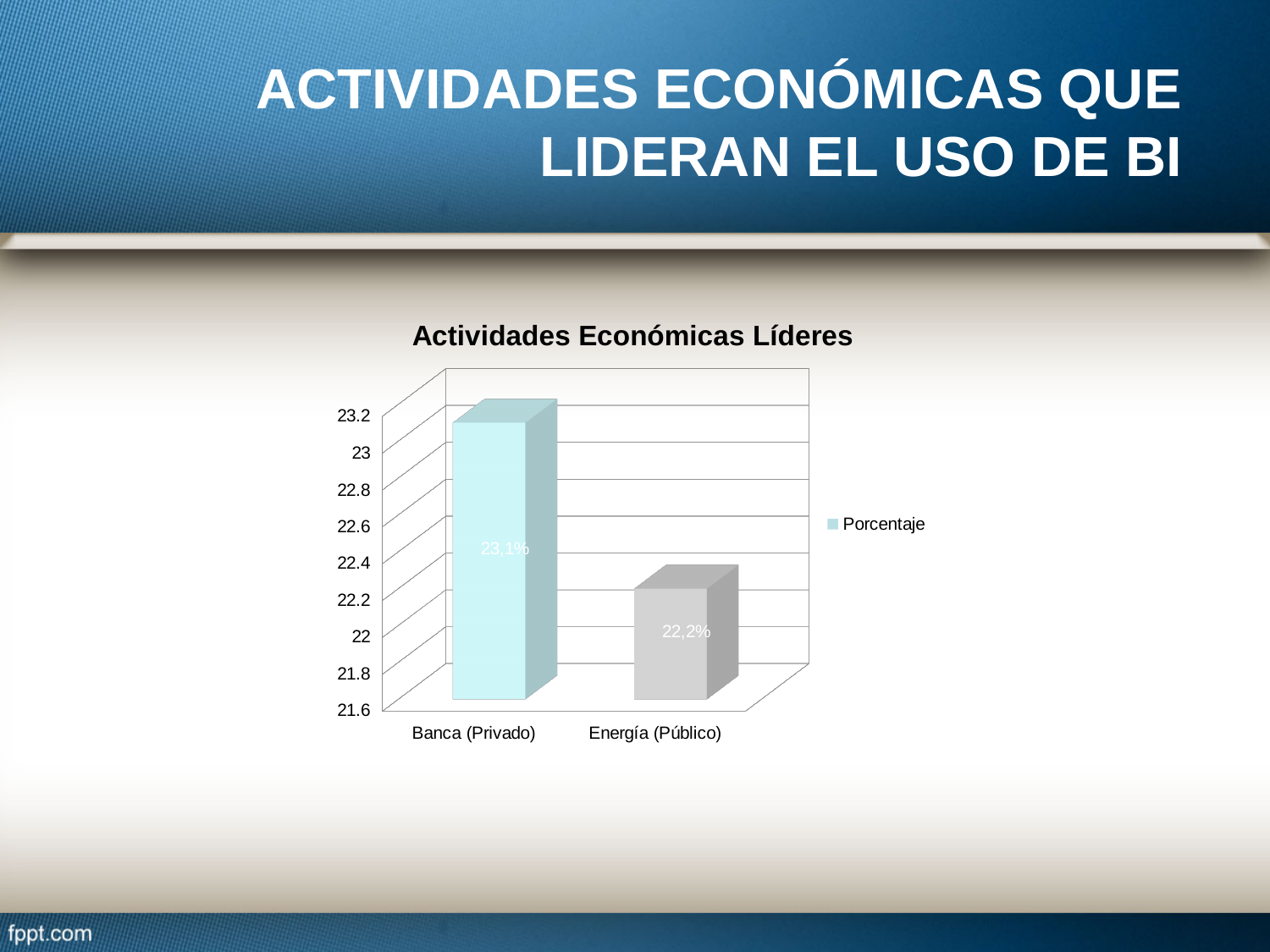
Which is larger, the value for Banca (Privado) or the value for Energía (Público)? Banca (Privado) What is the title of the chart? Actividades Económicas Líderes Which category has the lowest value? Energía (Público) What kind of chart is shown on the slide? bar chart What is the difference between the values for Banca (Privado) and Energía (Público)? 0,9% Which category has the highest value? Banca (Privado) What is the value for Banca (Privado)? 23,1% Is the value for Banca (Privado) greater or less than 22.6? greater Is the value for Energía (Público) greater or less than 23? less How many series does the legend list? 1 What is the value for Energía (Público)? 22,2% How many categories are shown in the chart? 2